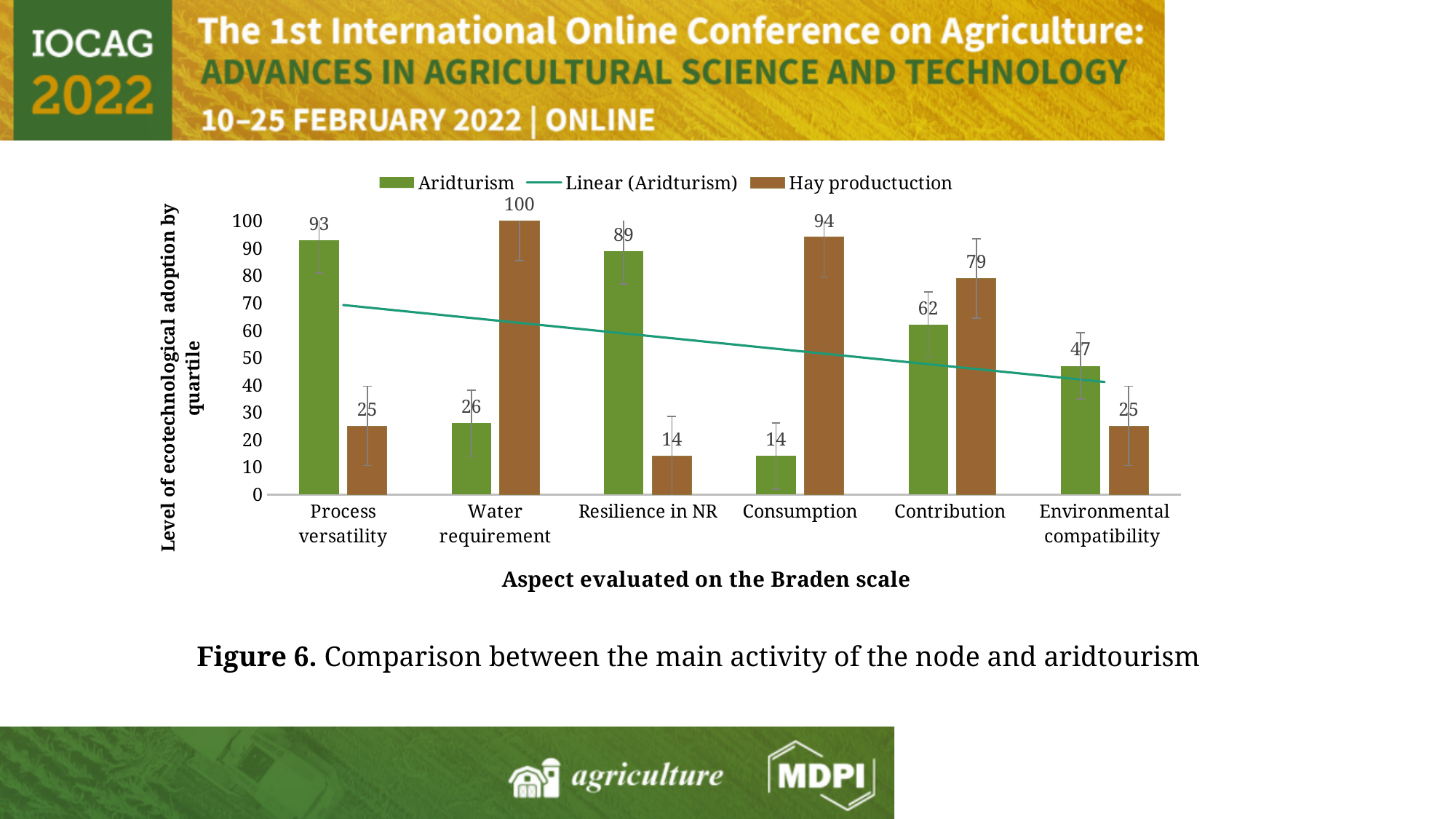
What is the difference between the Aridturism and Hay productuction values for Resilience in NR? 75 Which category has the highest Aridturism value? Process versatility What is the x-axis title of the chart? Aspect evaluated on the Braden scale What is the Hay productuction value for Water requirement? 100 What kind of chart is this? Bar chart Which category has the lowest Hay productuction value? Resilience in NR Which is larger for Environmental compatibility: the Aridturism value or the Hay productuction value? Aridturism How many entries does the legend list? 3 What is the Aridturism value for Consumption? 14 What is the Hay productuction value for Contribution? 79 What is the Aridturism value for Process versatility? 93 How many categories are shown on the x axis? 6